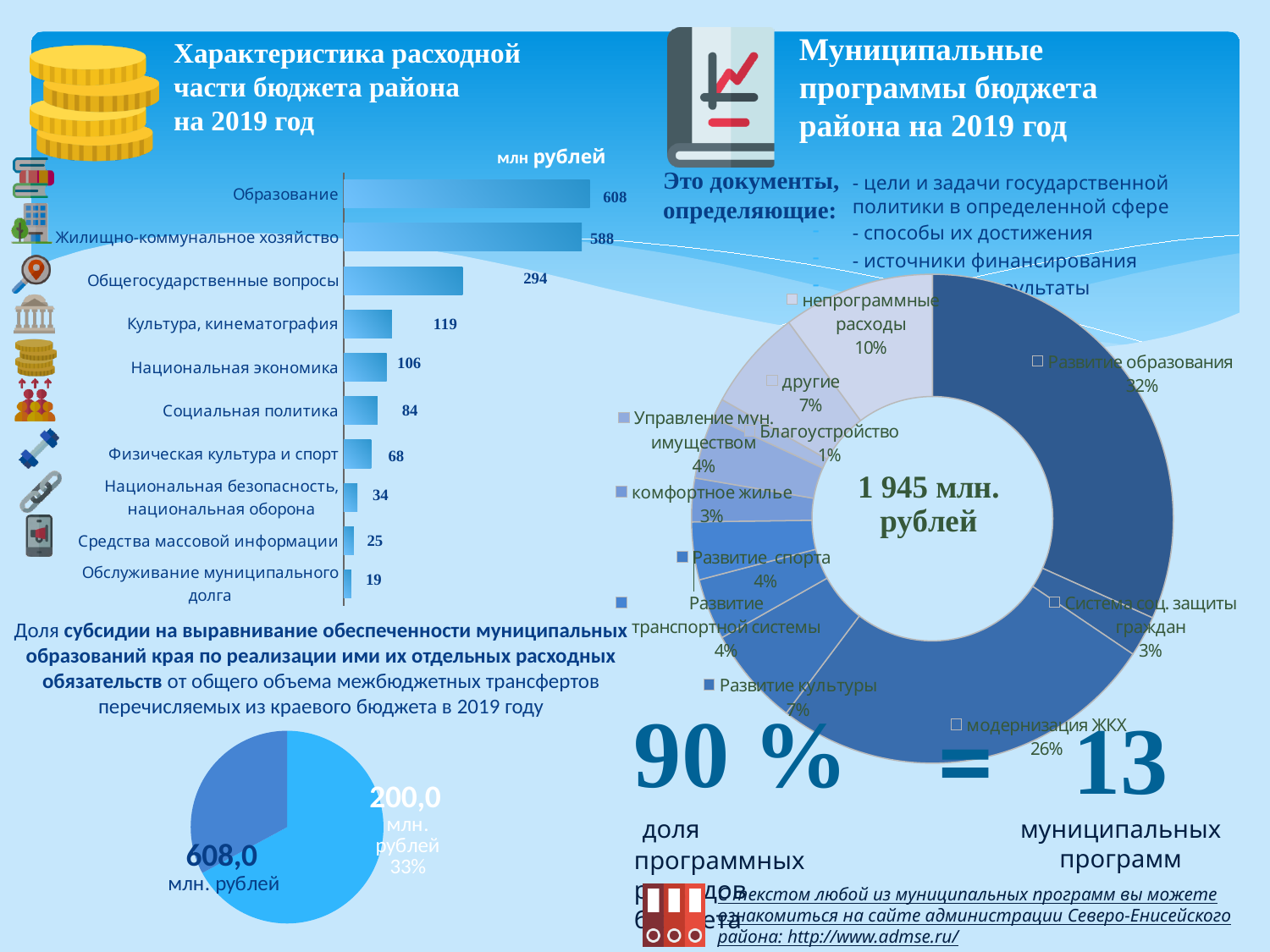
In the bar chart on the left, what is the difference between the values for Образование and Жилищно-коммунальное хозяйство? 20 How many categories are shown in the bar chart on the left? 10 In the bar chart on the left, which category has the highest value? Образование In the bar chart on the left, which is larger: Культура, кинематография or Национальная экономика? Культура, кинематография In the doughnut chart on the right, what share is shown for модернизация ЖКХ? 26% What kind of chart is the chart on the left showing budget expenditures by category? bar chart In the bar chart on the left, what is the value for Социальная политика? 84 In the doughnut chart on the right, what share is shown for Развитие образования? 32% In the doughnut chart on the right, which segment has the largest share? Развитие образования In the small pie chart at the bottom left, what percentage is shown for the 200,0 млн. рублей slice? 33% In the bar chart on the left, what is the value for Образование? 608 In the bar chart on the left, which category has the lowest value? Обслуживание муниципального долга